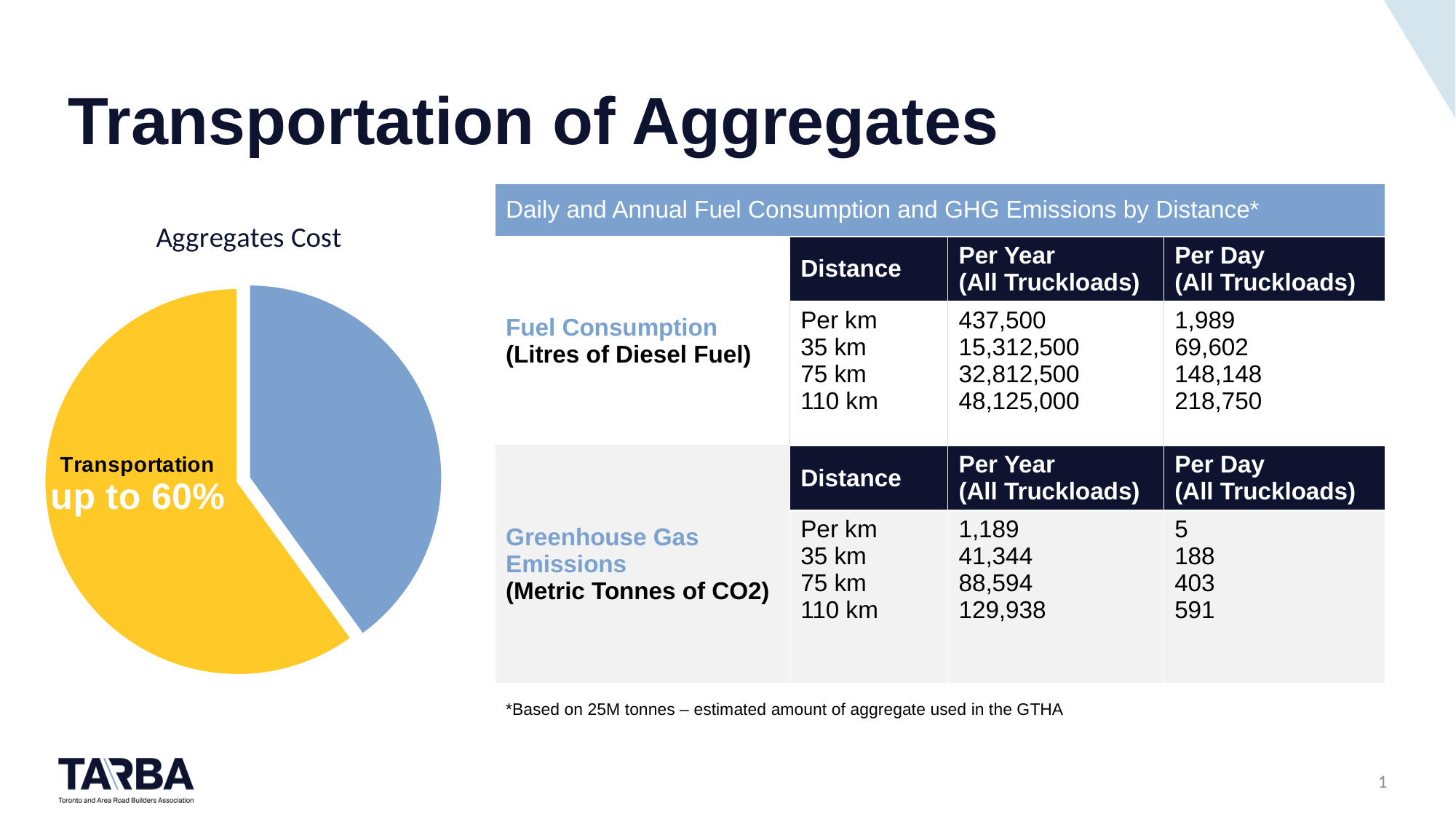
In the Aggregates Cost pie chart, what share is labelled for Transportation? up to 60% What is the title of the pie chart on the left of the slide? Aggregates Cost In the Aggregates Cost pie chart, is the Transportation slice larger or smaller than the blue slice? larger What kind of chart is shown under the heading "Aggregates Cost"? pie chart How many slices does the Aggregates Cost pie chart have? 2 Which slice is the largest in the Aggregates Cost pie chart? Transportation What colour is the Transportation slice in the Aggregates Cost pie chart? yellow